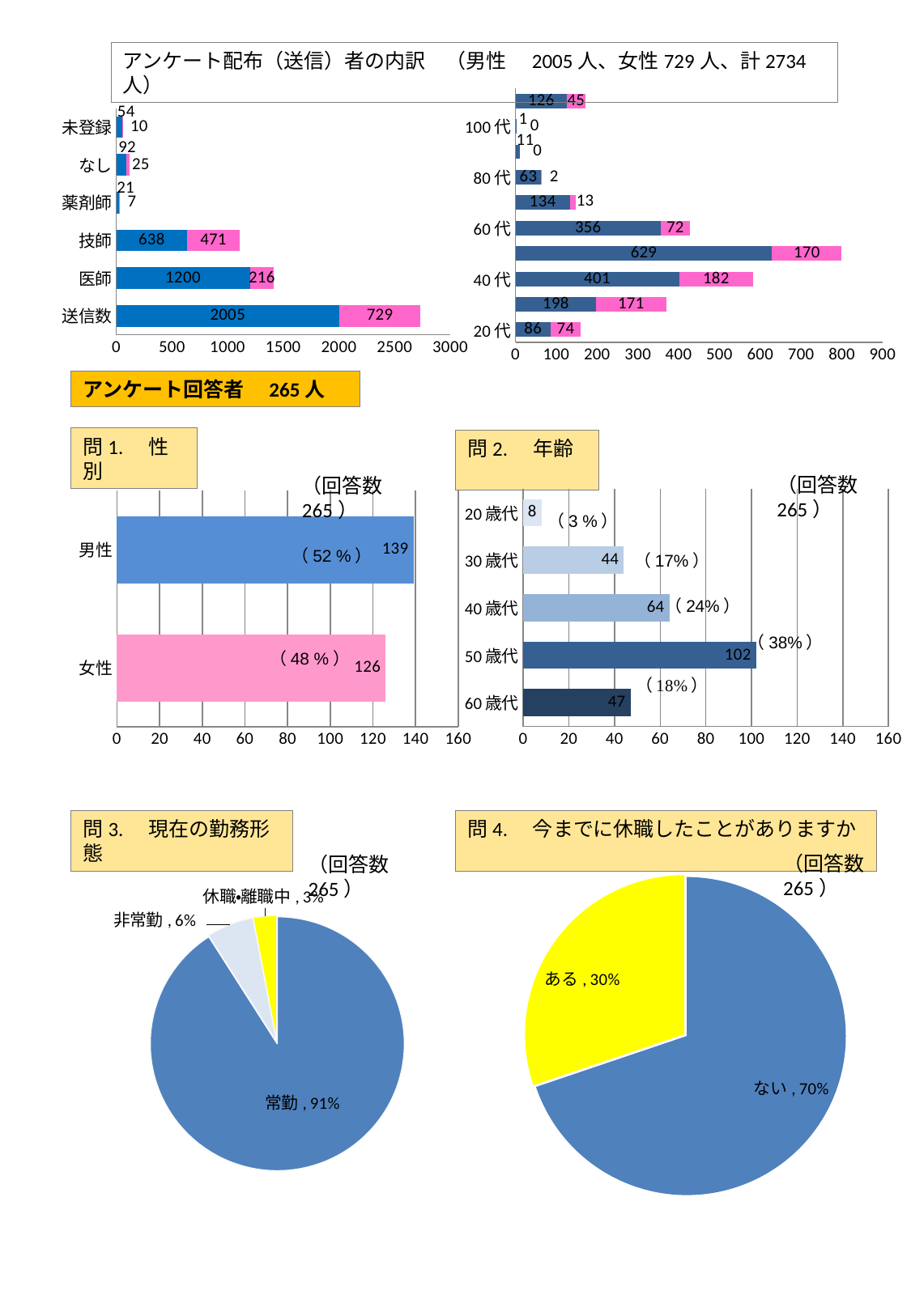
In the top-right stacked bar chart by age, what is the pink (female) value for 20代? 74 In the 問1 性別 bar chart, what is the value for 男性? 139 In the top-left stacked bar chart (アンケート配布者の内訳), what is the total of the 技師 bar? 1109 In the 問2 年齢 bar chart, which age group has the lowest value? 20歳代 In the 問1 性別 bar chart, what is the difference between the 男性 and 女性 values? 13 In the 問2 年齢 bar chart, what is the value for 40歳代? 64 In the 問3 現在の勤務形態 pie chart, what share does 常勤 have? 91% What kind of chart is used for 問4 今までに休職したことがありますか? pie chart How many age groups are shown in the 問2 年齢 bar chart? 5 In the 問2 年齢 bar chart, which age group has the highest value? 50歳代 In the 問4 pie chart, which is larger, ある or ない? ない In the top-left stacked bar chart (アンケート配布者の内訳), what is the blue (male) value for 医師? 1200